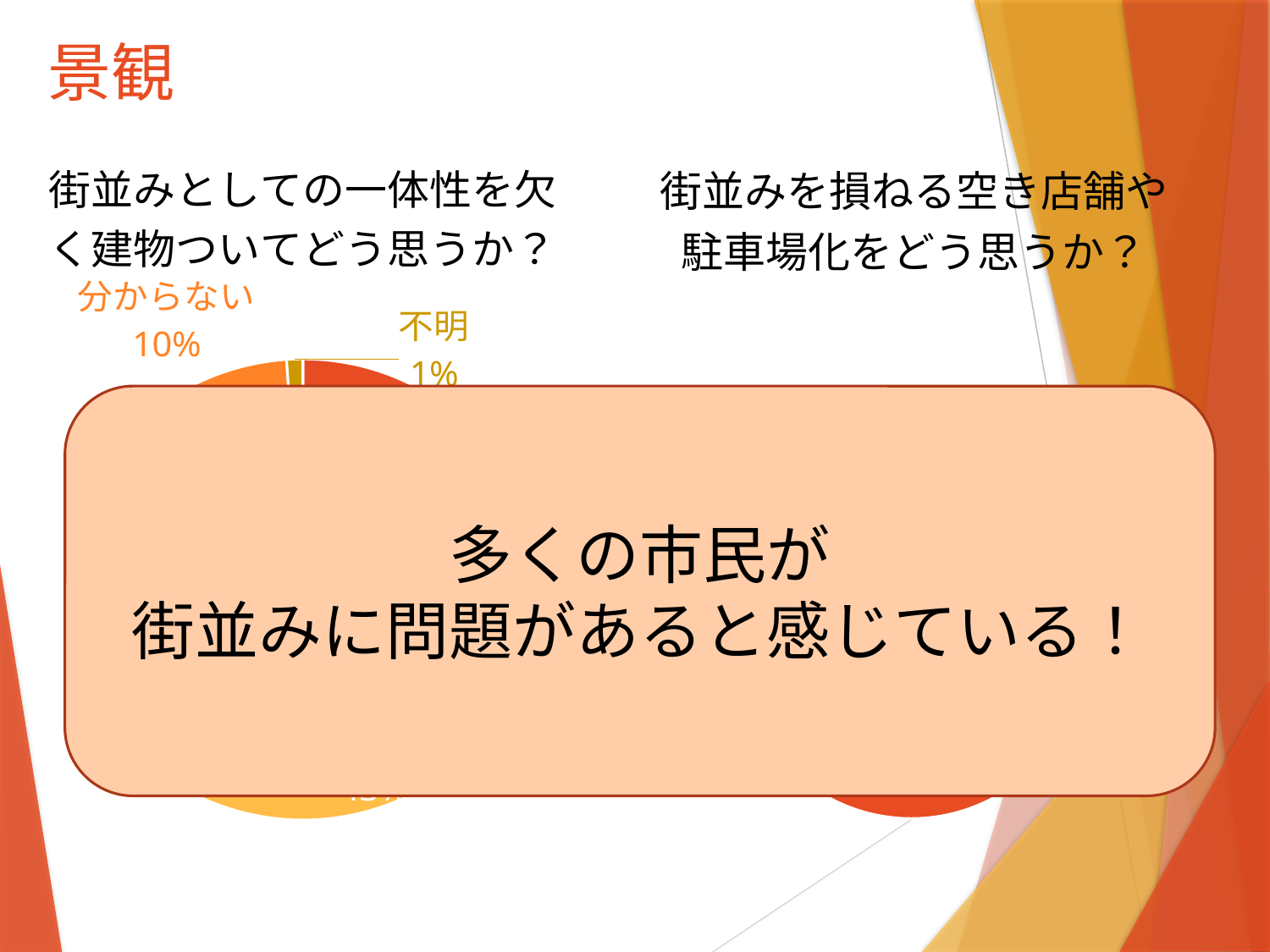
What is the title of the chart on the right side of the slide? 街並みを損ねる空き店舗や駐車場化をどう思うか？ What is the title of the chart on the left side of the slide? 街並みとしての一体性を欠く建物ついてどう思うか？ In the left chart (街並みとしての一体性を欠く建物ついてどう思うか？), what percentage is shown for 分からない? 10% What kind of chart is the left chart on the slide? Pie chart In the left chart (街並みとしての一体性を欠く建物ついてどう思うか？), what percentage is shown for 不明? 1% In the left chart, which is larger, the share for 分からない or the share for 不明? 分からない In the left chart, what is the difference between the 分からない share and the 不明 share? 9% How many charts are shown on the slide? 2